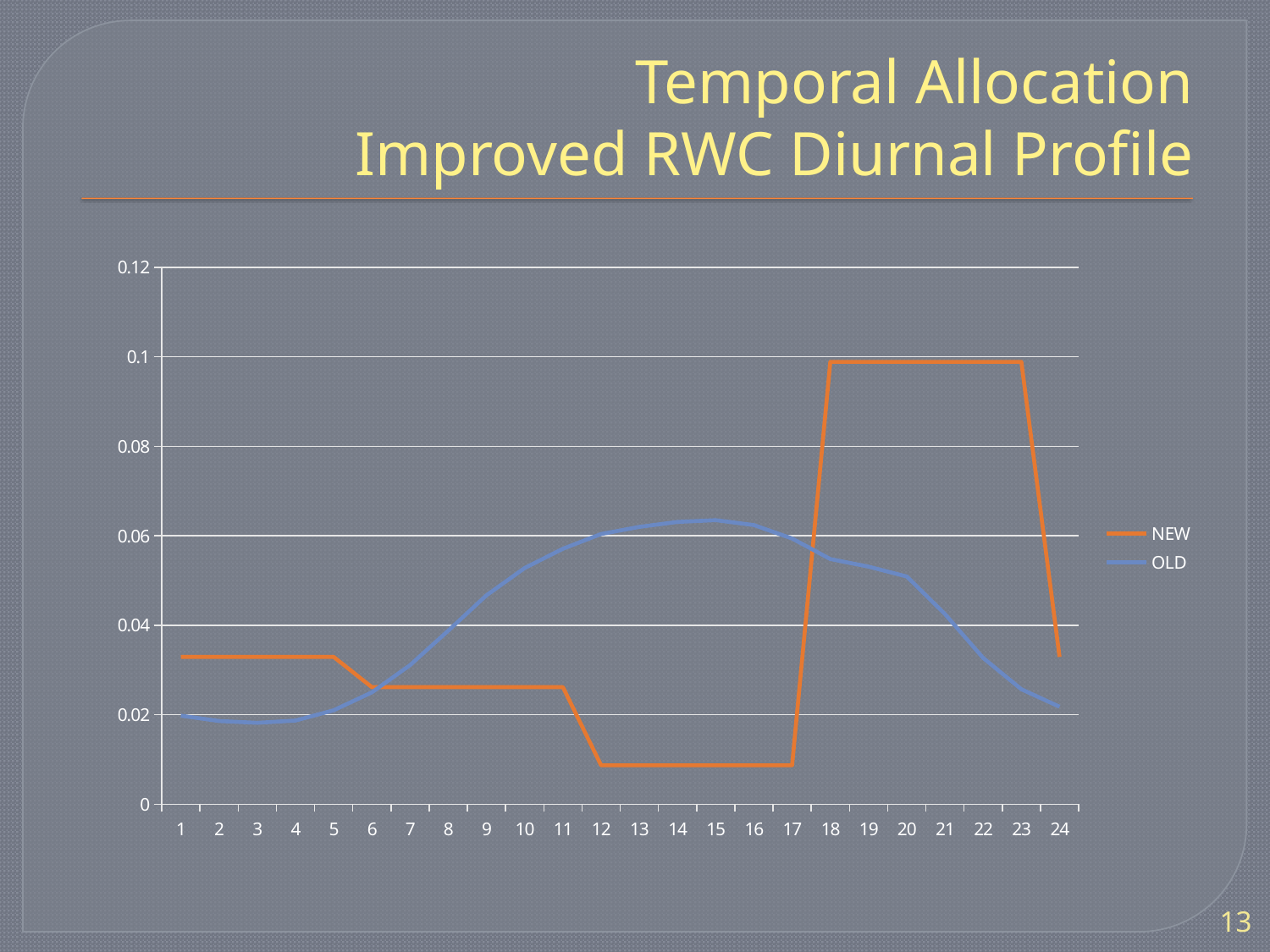
What are the two entries listed in the legend? NEW and OLD Does the OLD series rise or fall between hour 20 and hour 24? fall How many series does the legend list? 2 Which series reaches the highest value anywhere on the chart? NEW At hour 20, which series has the larger value, NEW or OLD? NEW What kind of chart is shown on the slide? line chart How many points are labelled along the x axis? 24 Is the value of the NEW series at hour 20 greater or less than 0.08? greater Is the value of the NEW series at hour 14 greater or less than 0.02? less Is the value of the OLD series at hour 15 greater or less than 0.04? greater At hour 14, which series has the larger value, NEW or OLD? OLD